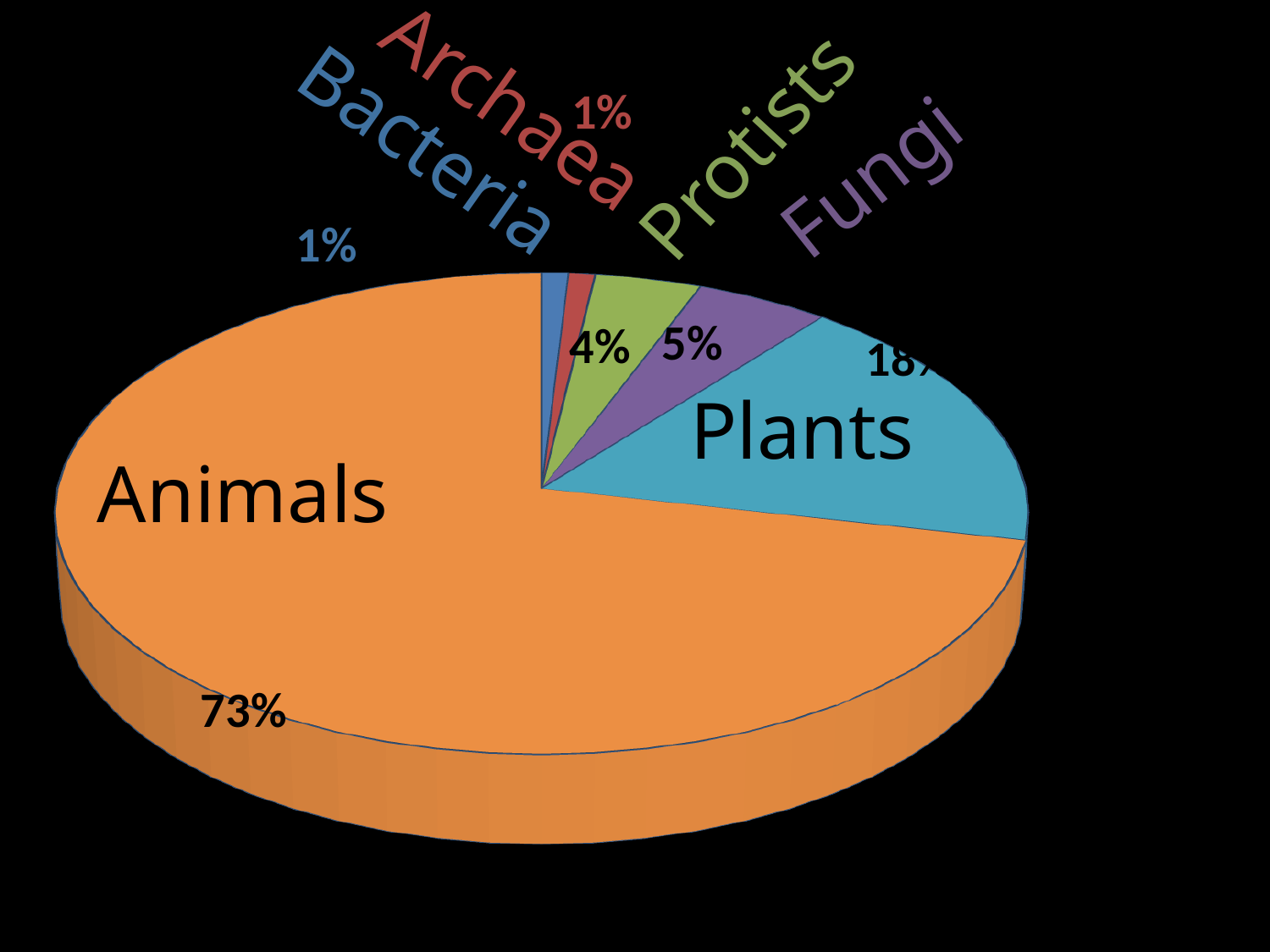
What is the difference between the Animals share and the Fungi share? 68% Which category has the largest slice of the pie? Animals Which slice is larger, Plants or Animals? Animals What colour is the Animals slice? orange What percentage of the pie is Animals? 73% What percentage of the pie is Archaea? 1% Which slice is larger, Fungi or Protists? Fungi What percentage of the pie is Bacteria? 1% What percentage of the pie is Fungi? 5% What kind of chart is shown on the slide? pie chart How many categories (slices) does the pie chart have? 6 What percentage of the pie is Protists? 4%